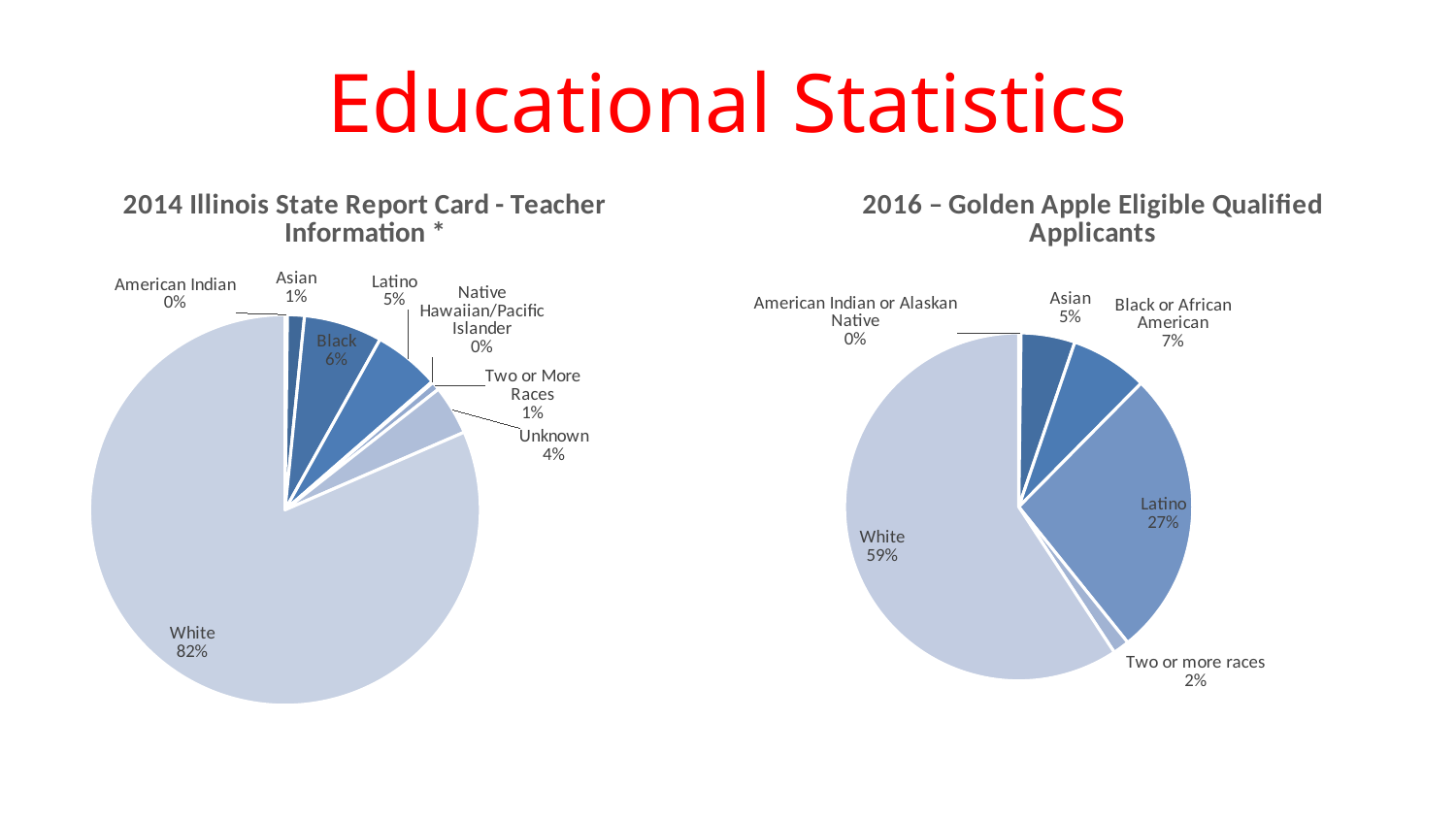
In the 2016 – Golden Apple Eligible Qualified Applicants chart, what share of the pie is Latino? 27% In the 2014 Illinois State Report Card - Teacher Information chart, what is the difference in percentage points between Black and Latino? 1 In the 2014 Illinois State Report Card - Teacher Information chart, what percentage is labelled for Black? 6% What type of chart is used for the 2016 – Golden Apple Eligible Qualified Applicants data? Pie chart In the 2014 Illinois State Report Card - Teacher Information chart, what share of the pie is White? 82% In the 2016 – Golden Apple Eligible Qualified Applicants chart, which category has the largest slice? White In the 2014 Illinois State Report Card - Teacher Information chart, how many categories are labelled on the pie? 8 In the 2016 – Golden Apple Eligible Qualified Applicants chart, what is the difference in percentage points between White and Latino? 32 In the 2016 – Golden Apple Eligible Qualified Applicants chart, which is larger, Asian or Two or more races? Asian In the 2016 – Golden Apple Eligible Qualified Applicants chart, what percentage is shown for Black or African American? 7% In the 2014 Illinois State Report Card - Teacher Information chart, which category has the largest slice? White In the 2014 Illinois State Report Card - Teacher Information chart, what percentage is shown for Unknown? 4%